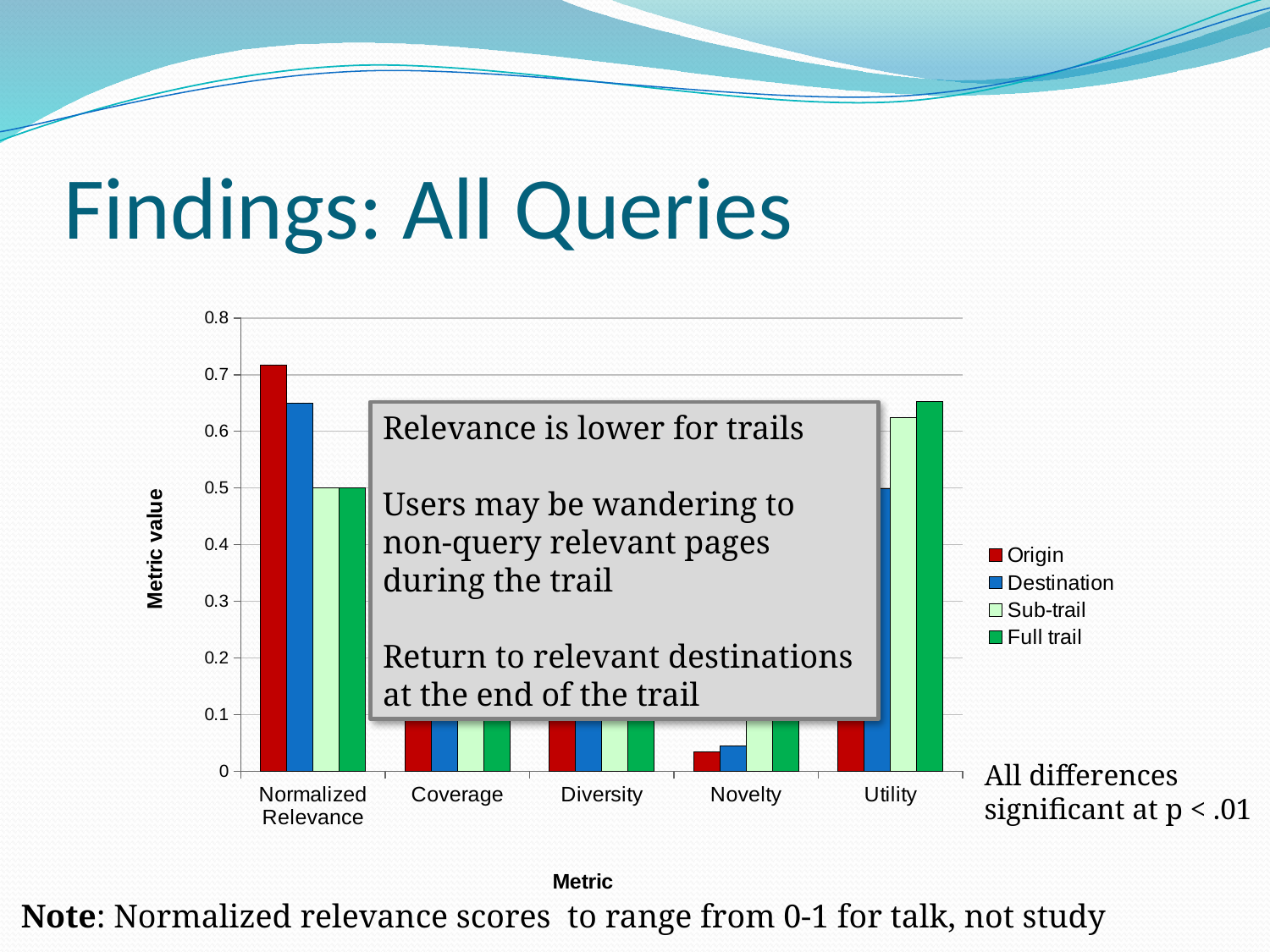
What is the label of the chart's vertical axis? Metric value Which series are listed in the chart's legend? Origin, Destination, Sub-trail, Full trail Is the Origin value for Novelty greater or less than 0.1? less Which is larger for Normalized Relevance: the Origin value or the Destination value? Origin For Normalized Relevance, which series has the highest value? Origin How many metric categories are shown on the x axis of the chart? 5 For Novelty, which series has the lowest value? Origin Is the Destination value for Normalized Relevance greater or less than 0.6? greater Is the Origin value for Normalized Relevance greater or less than 0.6? greater What kind of chart is shown on the slide? bar chart How many series does the chart's legend list? 4